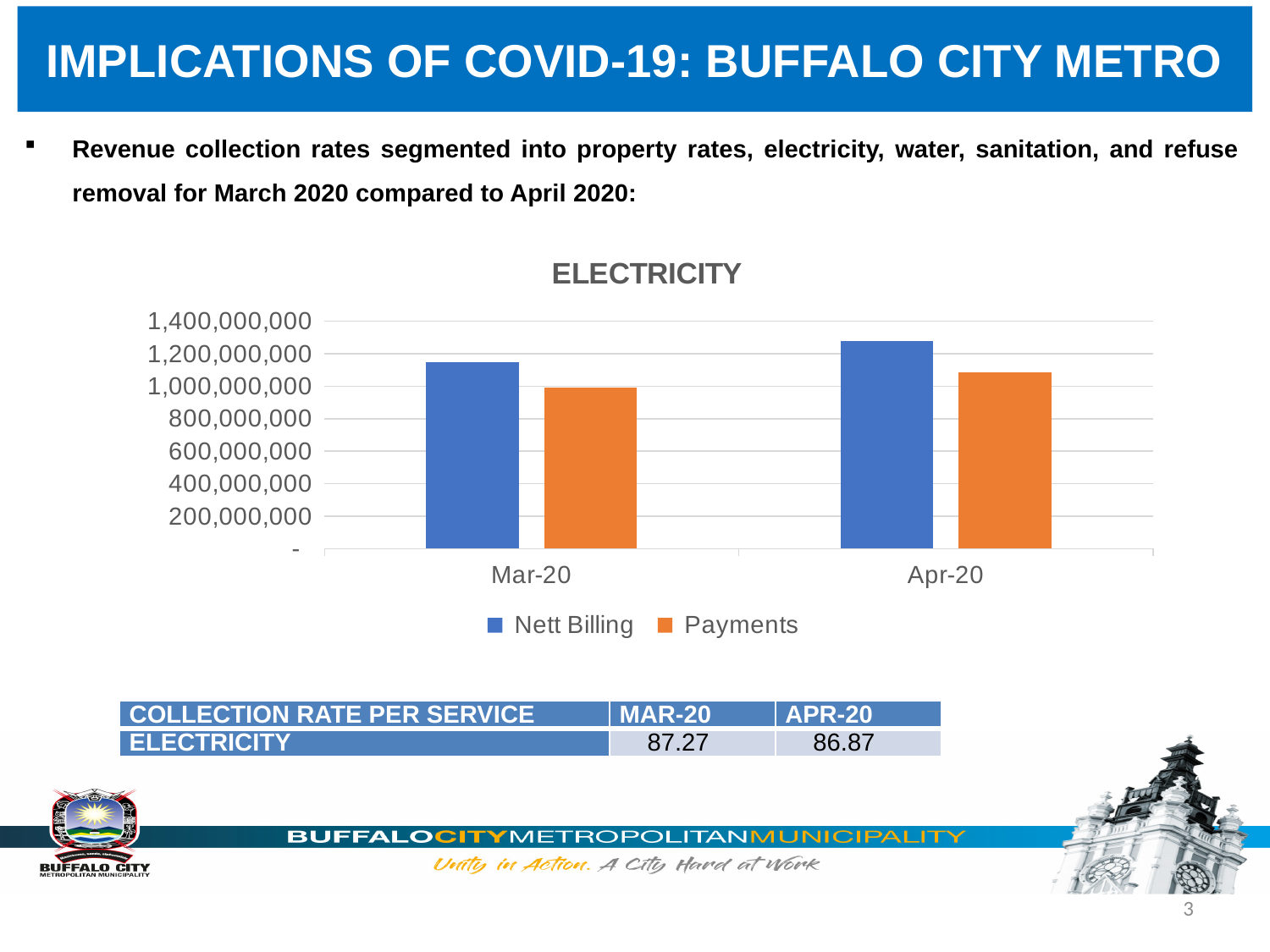
Does Nett Billing rise or fall from Mar-20 to Apr-20? Rise Is the Payments value for Mar-20 greater or less than 1,200,000,000? less What kind of chart is shown on the slide? Bar chart Is the Nett Billing value for Apr-20 greater or less than 1,200,000,000? greater How many categories are shown on the x axis of the chart? 2 Which series is shown in orange in the chart? Payments Which bar in the chart is the highest? Nett Billing for Apr-20 In Mar-20, which is larger: Nett Billing or Payments? Nett Billing Is the Nett Billing value for Mar-20 greater or less than 1,000,000,000? greater How many series does the chart legend list? 2 What is the title of the chart? ELECTRICITY